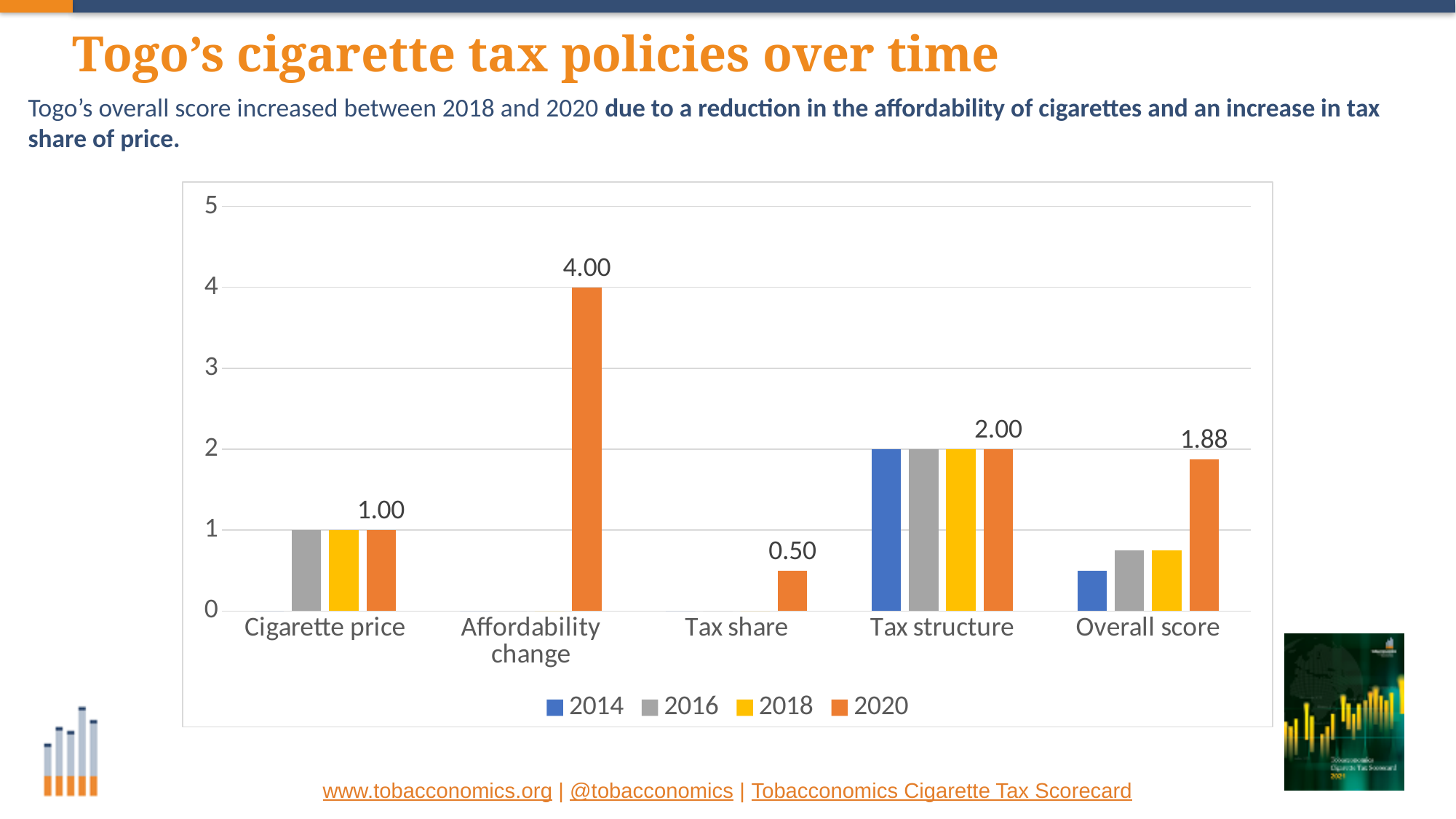
Is the 2014 value for Overall score greater or less than 1? less How many series does the legend list? 4 What is the 2020 value for Tax share? 0.50 What kind of chart is shown on the slide? bar chart Which category has the lowest 2020 value? Tax share Which is larger in 2020: Overall score or Tax structure? Tax structure Which category has the highest 2020 value? Affordability change What is the 2020 value for Affordability change? 4.00 What is the difference between the 2020 values for Affordability change and Tax structure? 2.00 What is the 2020 value for Overall score? 1.88 What is the difference between the 2020 values for Overall score and Cigarette price? 0.88 How many categories are shown on the x axis? 5